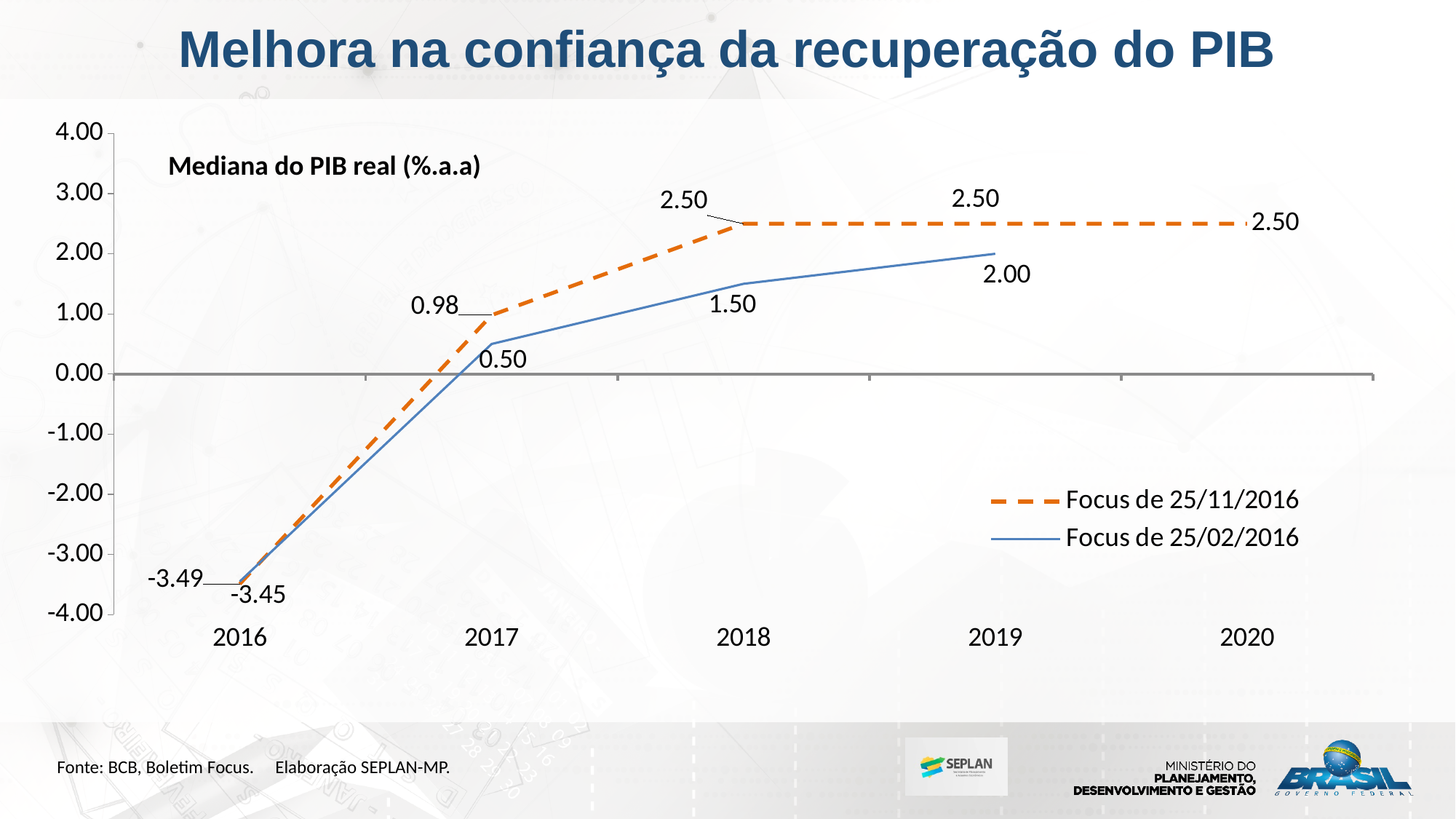
How many series does the legend list? 2 Which series has the higher value in 2018, Focus de 25/11/2016 or Focus de 25/02/2016? Focus de 25/11/2016 What is the value for Focus de 25/02/2016 in 2016? -3.45 Does the Focus de 25/02/2016 series rise or fall from 2016 to 2019? rise What kind of chart is shown on the slide? line chart In which year is the Focus de 25/02/2016 series at its lowest? 2016 How many years are shown on the x axis? 5 What is the value for Focus de 25/11/2016 in 2020? 2.50 What is the value for Focus de 25/02/2016 in 2018? 1.50 What is the difference between the Focus de 25/11/2016 and Focus de 25/02/2016 values in 2019? 0.50 What is the value for Focus de 25/11/2016 in 2017? 0.98 What is the title printed inside the chart area? Mediana do PIB real (%.a.a)